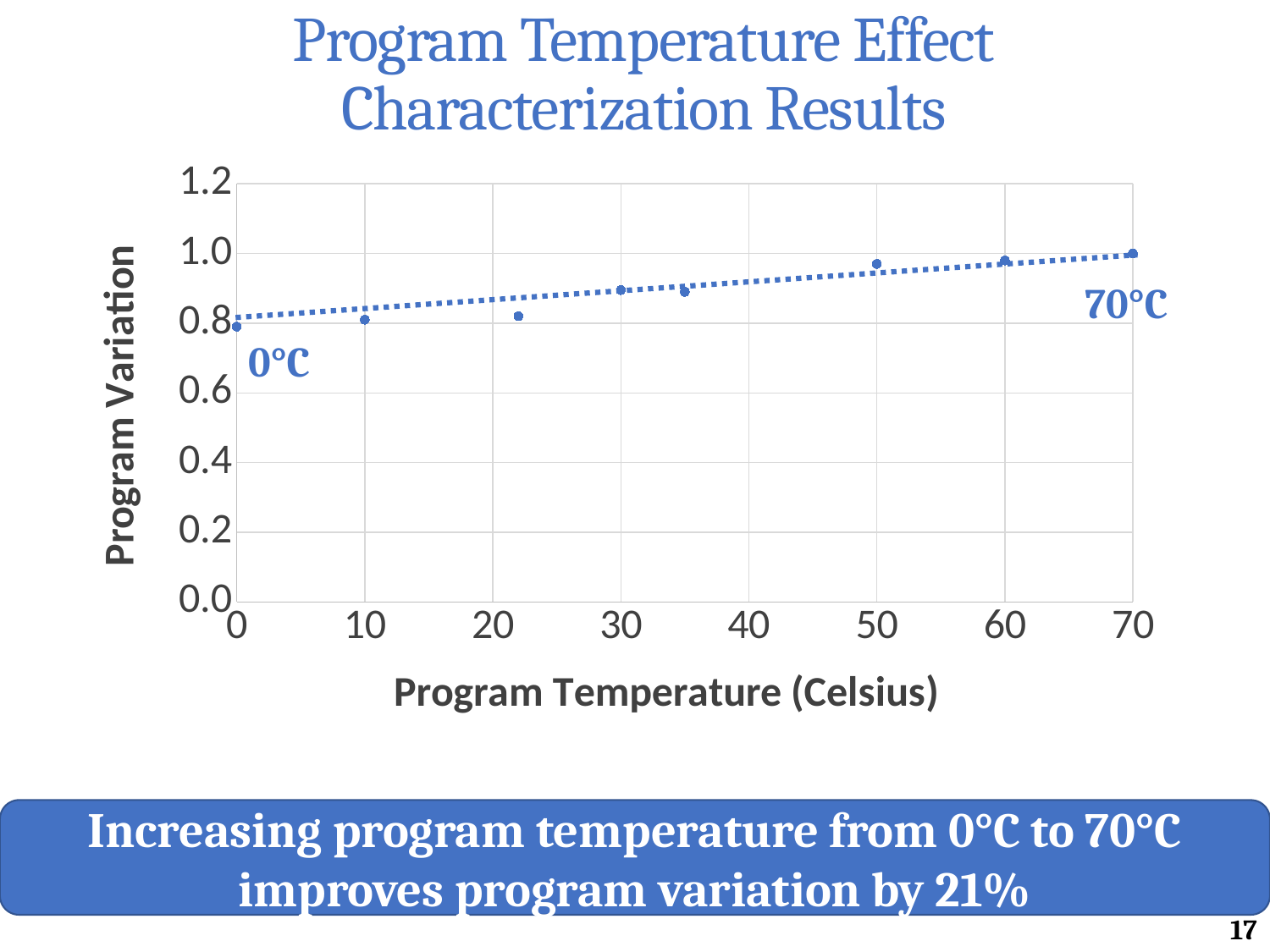
Is the Program Variation value at 70 degrees Celsius greater or less than 0.8? greater What is the title of the x axis? Program Temperature (Celsius) Which has the larger Program Variation value: the point at 0 degrees Celsius or the point at 70 degrees Celsius? 70 degrees Celsius Is the Program Variation value at 30 degrees Celsius greater or less than 0.6? greater Which has the larger Program Variation value: the point at 10 degrees Celsius or the point at 50 degrees Celsius? 50 degrees Celsius How many data points are plotted on the chart? 8 Is the Program Variation value at 10 degrees Celsius greater or less than 1.0? less What is the title of the y axis? Program Variation What kind of chart is shown on the slide? scatter chart Do the Program Variation values rise or fall as Program Temperature increases along the x axis? rise